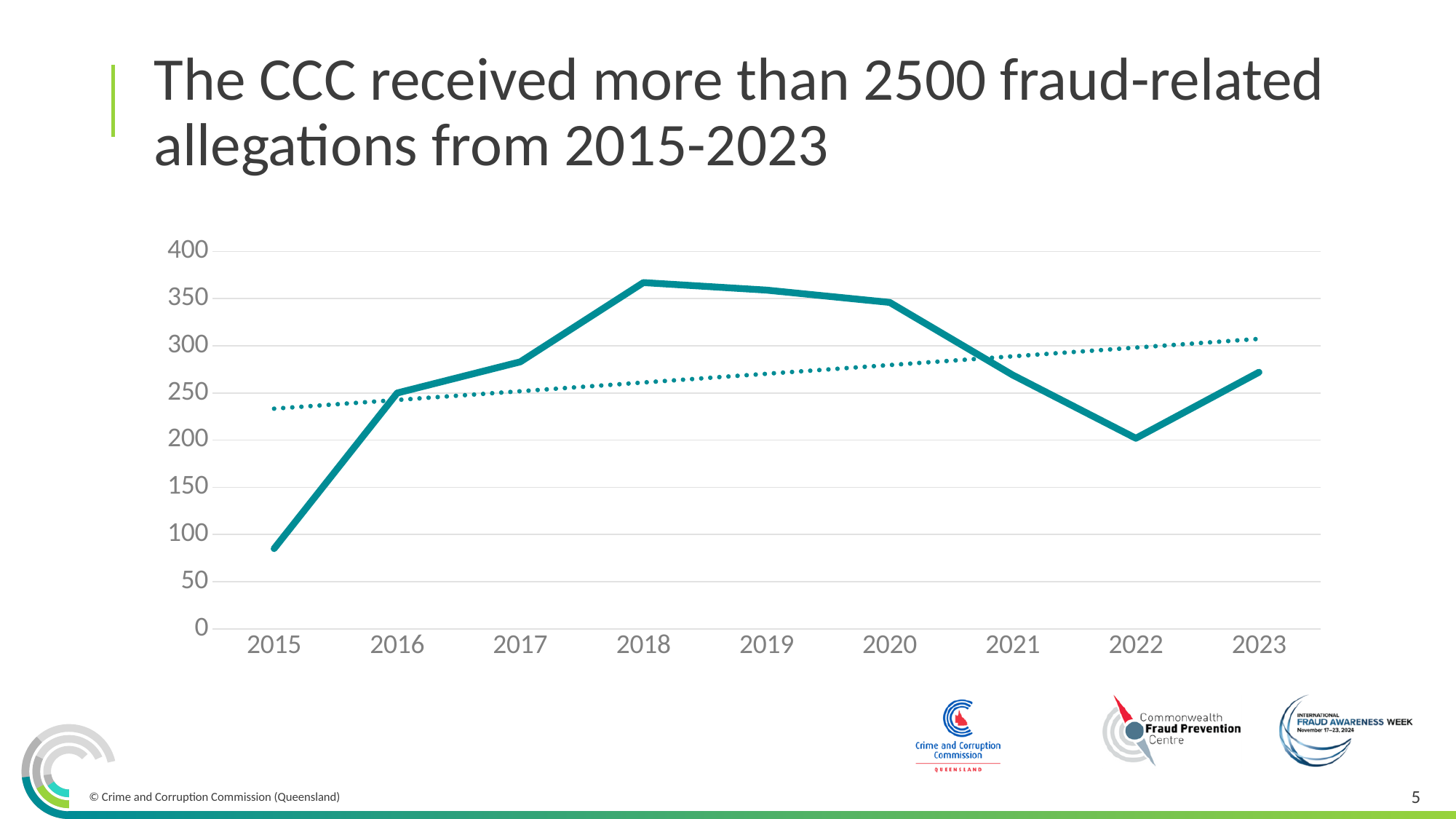
Which year has the higher value, 2016 or 2022? 2016 Is the value for 2022 greater or less than 250? less Which year has the higher value, 2020 or 2023? 2020 Do the values on the solid line rise or fall from 2018 to 2022? fall Is the value for 2023 greater or less than 250? greater Is the value for 2018 greater or less than 350? greater How many years are plotted along the x axis of the chart? 9 What kind of chart is shown on the slide? line chart In which year does the solid line have its lowest value? 2015 In which year does the solid line reach its highest value? 2018